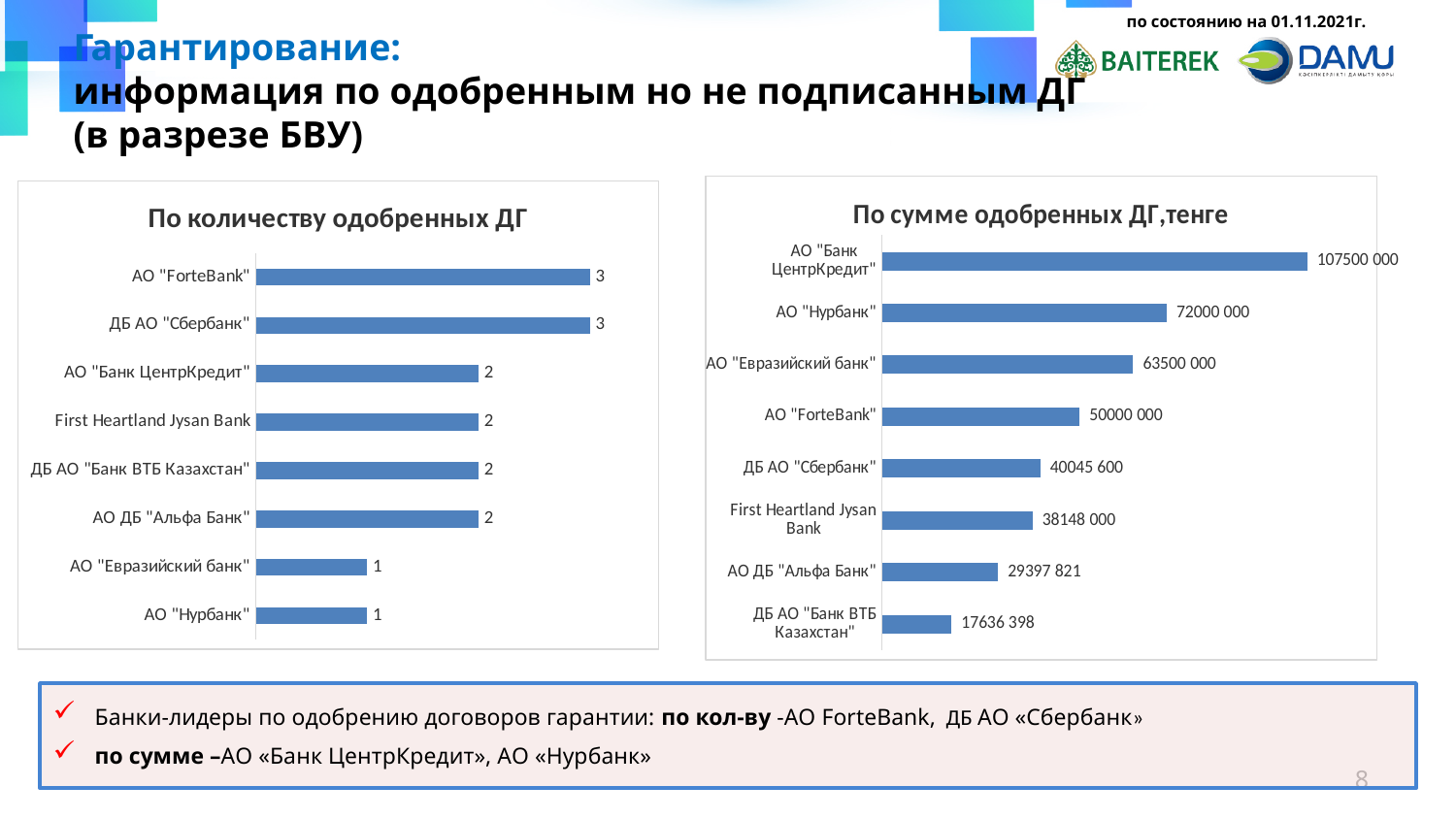
What is the title of the chart on the left side of the slide? По количеству одобренных ДГ In the chart "По сумме одобренных ДГ,тенге", which bank has the lowest value? ДБ АО "Банк ВТБ Казахстан" In the chart "По сумме одобренных ДГ,тенге", which is larger: АО "ForteBank" or АО "Евразийский банк"? АО "Евразийский банк" What type of chart is the chart "По сумме одобренных ДГ,тенге"? Bar chart In the chart "По количеству одобренных ДГ", what is the difference between ДБ АО "Сбербанк" and АО "Нурбанк"? 2 In the chart "По сумме одобренных ДГ,тенге", which bank has the highest value? АО "Банк ЦентрКредит" In the chart "По сумме одобренных ДГ,тенге", what is the value for ДБ АО "Сбербанк"? 40045 600 In the chart "По количеству одобренных ДГ", what is the value for АО "Евразийский банк"? 1 In the chart "По сумме одобренных ДГ,тенге", what is the difference between АО "Банк ЦентрКредит" and АО "Нурбанк"? 35500 000 In the chart "По количеству одобренных ДГ", how many banks are shown? 8 In the chart "По сумме одобренных ДГ,тенге", what is the value for АО "Нурбанк"? 72000 000 In the chart "По количеству одобренных ДГ", what is the value for АО "ForteBank"? 3